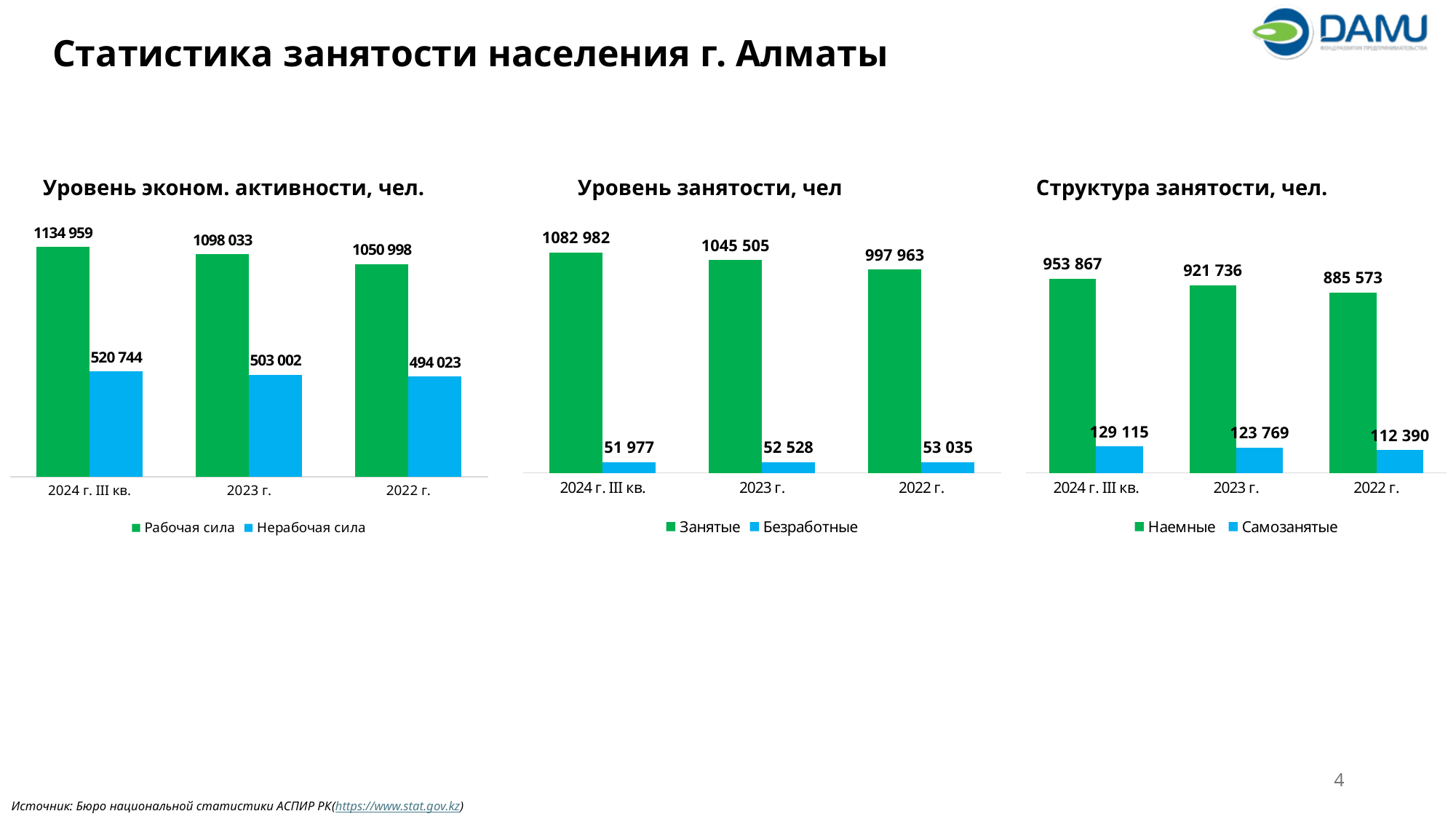
In the chart 'Уровень занятости, чел', which period has the lowest value of Занятые? 2022 г. What kind of chart is 'Уровень эконом. активности, чел.'? bar chart In the chart 'Уровень занятости, чел', what is the value of Безработные for 2023 г.? 52 528 In the chart 'Структура занятости, чел.', which period has the highest value of Наемные? 2024 г. III кв. In the chart 'Структура занятости, чел.', what is the value of Самозанятые for 2024 г. III кв.? 129 115 How many series does the legend of the chart 'Структура занятости, чел.' list? 2 In the chart 'Уровень эконом. активности, чел.', what is the value of Нерабочая сила for 2022 г.? 494 023 In the chart 'Уровень эконом. активности, чел.', what is the difference between Рабочая сила in 2024 г. III кв. and in 2023 г.? 36 926 In the chart 'Уровень эконом. активности, чел.', what is the value of Рабочая сила for 2024 г. III кв.? 1134 959 In the chart 'Уровень занятости, чел', what is the difference between Безработные in 2022 г. and in 2024 г. III кв.? 1 058 In the chart 'Структура занятости, чел.', what is the difference between Наемные in 2024 г. III кв. and in 2022 г.? 68 294 In the chart 'Уровень занятости, чел', do the Занятые values rise or fall going from 2024 г. III кв. to 2022 г. along the x axis? fall